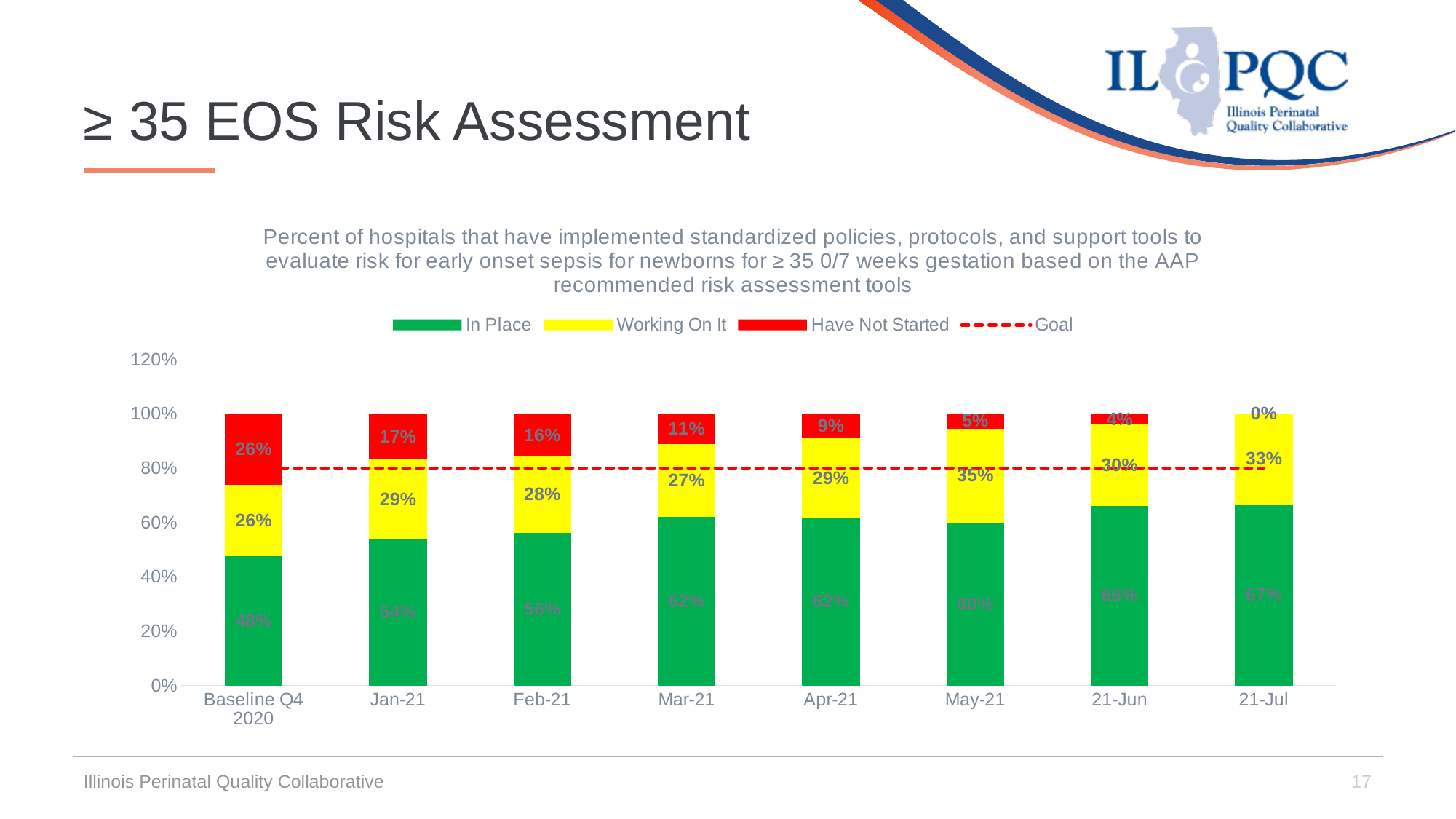
Does the Have Not Started percentage generally rise or fall from Baseline Q4 2020 to 21-Jul? Fall What percentage of hospitals had the EOS risk assessment In Place at Baseline Q4 2020? 48% Which period has the highest In Place percentage? 21-Jul How many entries does the legend list? 4 Is the Have Not Started value larger for Jan-21 or for Apr-21? Jan-21 What is the Have Not Started value for Mar-21? 11% Is the In Place value for 21-Jun greater or less than 60%? greater Which period has the lowest Have Not Started percentage? 21-Jul By how many percentage points did the In Place value increase from Baseline Q4 2020 to 21-Jul? 19 percentage points What is the Working On It value for May-21? 35% How many time periods are shown on the x axis? 8 What kind of chart is shown on the slide? Stacked bar chart